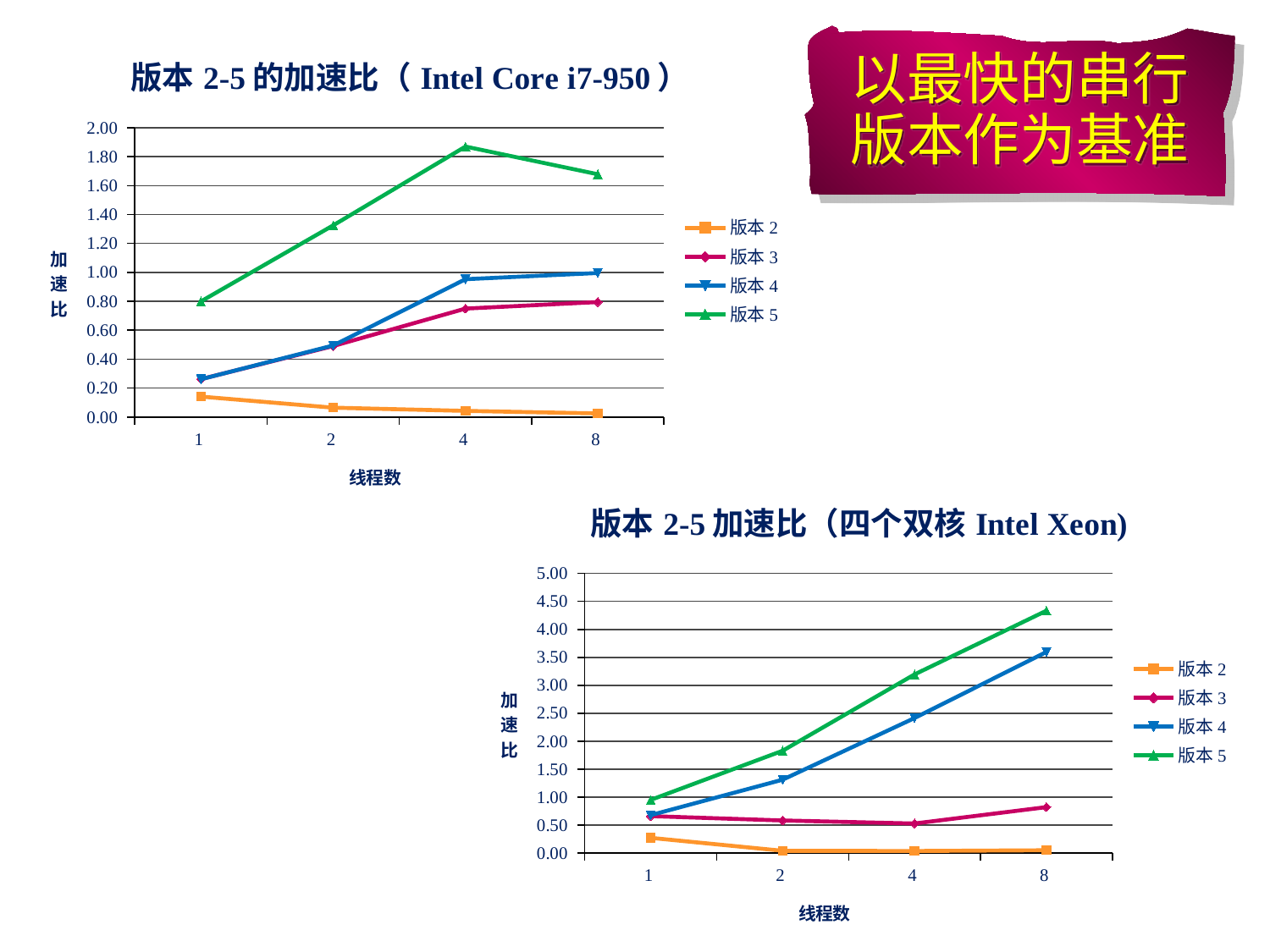
In the top chart (Intel Core i7-950), is the value for 版本 5 at 4 threads greater or less than 1.80? greater In the top chart (Intel Core i7-950), does the speedup of 版本 2 rise or fall as the thread count increases? fall What is the x-axis label of the bottom chart (四个双核 Intel Xeon)? 线程数 In the bottom chart (四个双核 Intel Xeon), does the speedup of 版本 4 rise or fall as the thread count increases from 1 to 8? rise In the top chart (Intel Core i7-950), which series has the lowest speedup at 8 threads? 版本 2 In the top chart (Intel Core i7-950), how many thread-count points are plotted on the x axis? 4 In the top chart (Intel Core i7-950), which is larger at 2 threads: 版本 5 or 版本 4? 版本 5 In the bottom chart (四个双核 Intel Xeon), which series has the highest speedup at 8 threads? 版本 5 In the bottom chart (四个双核 Intel Xeon), is the value for 版本 5 at 8 threads greater or less than 4.00? greater What kind of chart is the top chart titled 版本 2-5 的加速比 (Intel Core i7-950)? line chart In the top chart (Intel Core i7-950), which series has the highest speedup at 4 threads? 版本 5 How many series does the legend of the top chart (Intel Core i7-950) list? 4